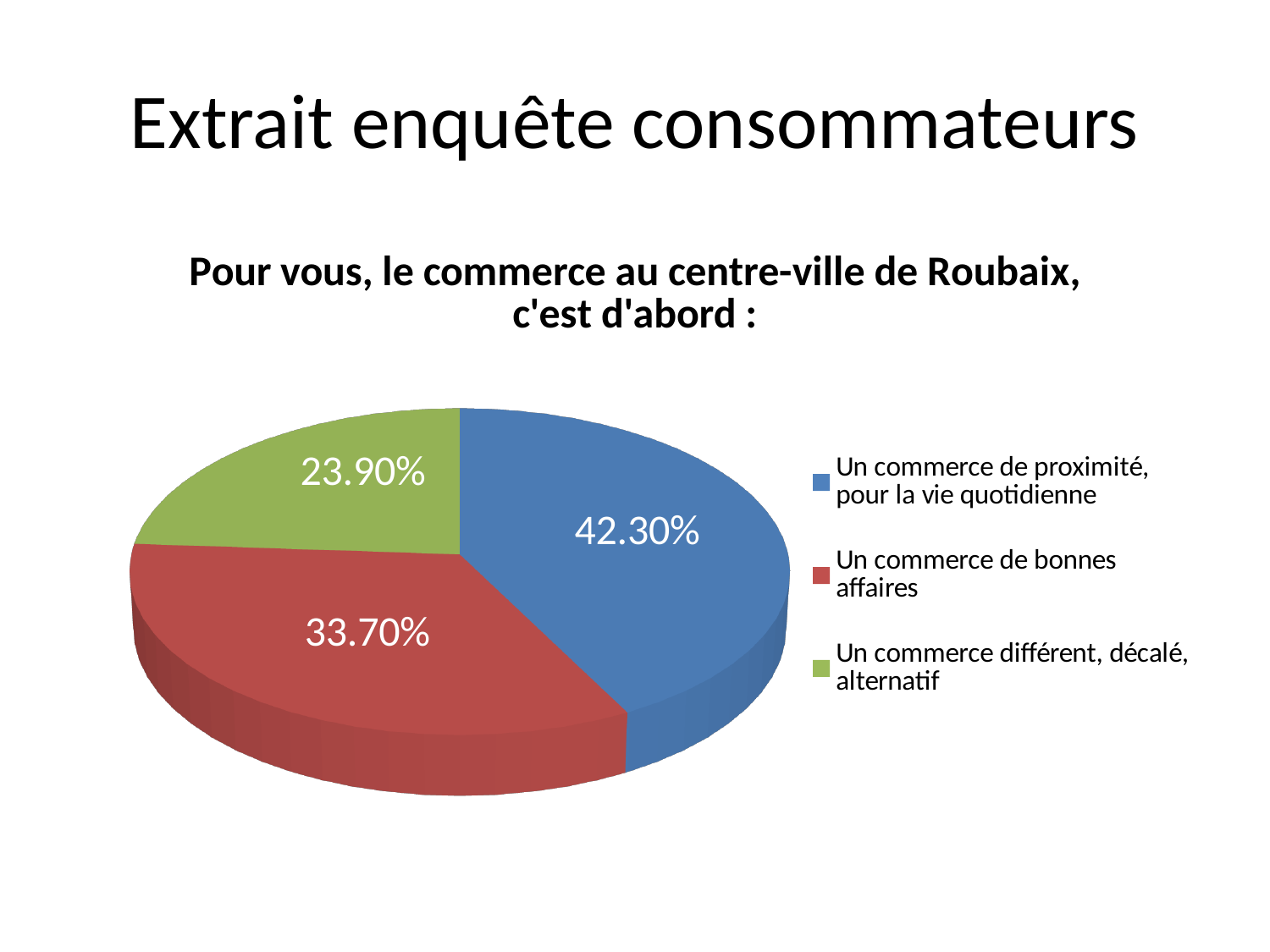
What colour is the slice for 'Un commerce différent, décalé, alternatif'? Green What share of the pie is 'Un commerce de proximité, pour la vie quotidienne'? 42.30% What share of the pie is 'Un commerce de bonnes affaires'? 33.70% How many categories does the pie chart show? 3 What is the difference between the shares for 'Un commerce de bonnes affaires' and 'Un commerce différent, décalé, alternatif'? 9.80% What is the difference between the shares for 'Un commerce de proximité, pour la vie quotidienne' and 'Un commerce de bonnes affaires'? 8.60% Which category has the smallest slice of the pie? Un commerce différent, décalé, alternatif What type of chart is shown on the slide? Pie chart Which is larger: the share for 'Un commerce de bonnes affaires' or for 'Un commerce différent, décalé, alternatif'? Un commerce de bonnes affaires Which category has the largest slice of the pie? Un commerce de proximité, pour la vie quotidienne What share of the pie is 'Un commerce différent, décalé, alternatif'? 23.90% What is the chart's title? Pour vous, le commerce au centre-ville de Roubaix, c'est d'abord :